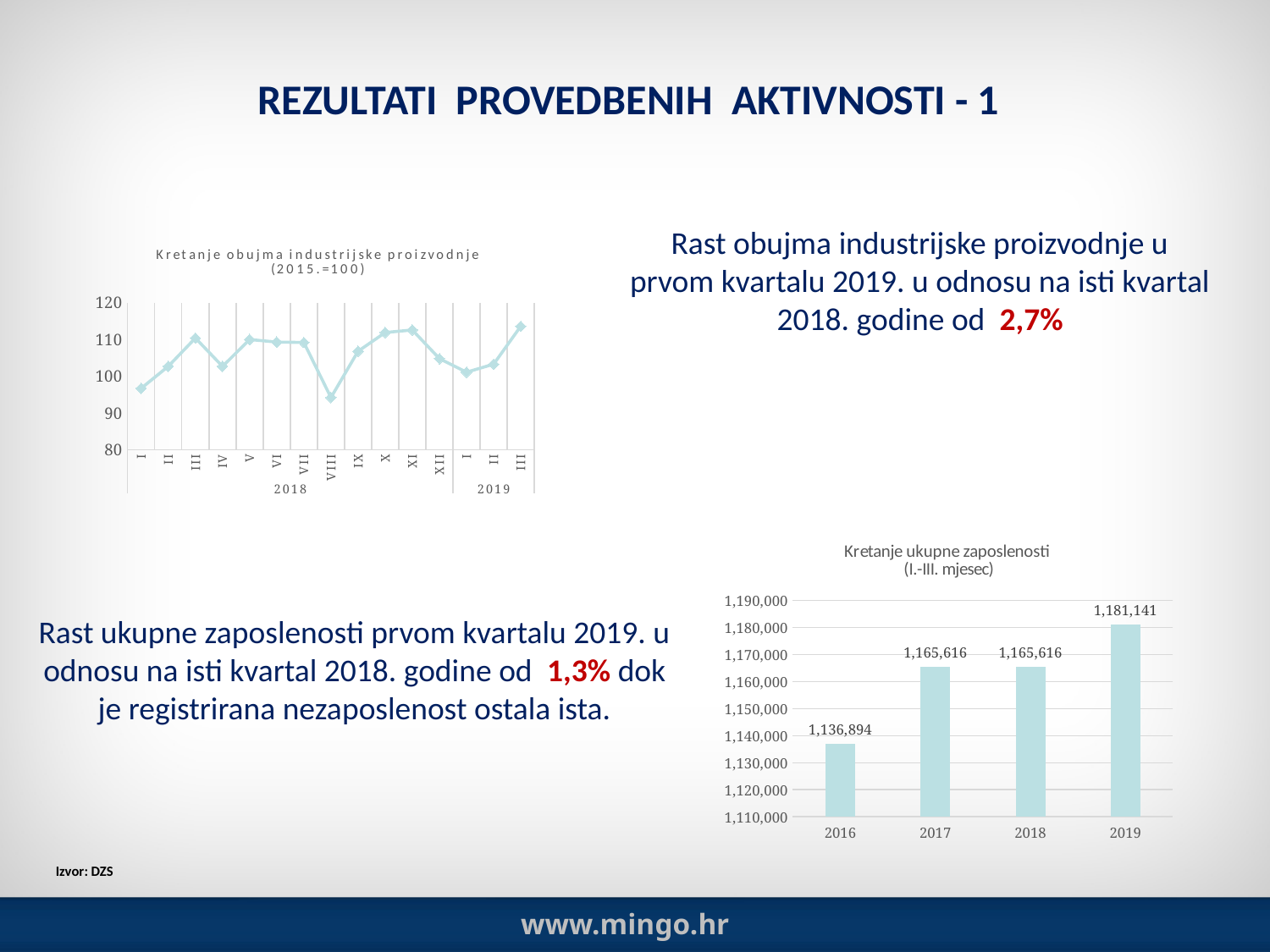
In the chart 'Kretanje obujma industrijske proizvodnje (2015.=100)', is the value for VIII 2018 greater or less than 100? less In the chart 'Kretanje ukupne zaposlenosti (I.-III. mjesec)', what is the value for 2016? 1,136,894 What kind of chart is 'Kretanje obujma industrijske proizvodnje (2015.=100)'? Line chart In the chart 'Kretanje ukupne zaposlenosti (I.-III. mjesec)', what is the difference between the values for 2019 and 2016? 44,247 In the chart 'Kretanje ukupne zaposlenosti (I.-III. mjesec)', is the value for 2017 larger or smaller than the value for 2018? They are equal (1,165,616) In the chart 'Kretanje obujma industrijske proizvodnje (2015.=100)', which month has the lowest value? VIII 2018 How many bars are shown in the chart 'Kretanje ukupne zaposlenosti (I.-III. mjesec)'? 4 In the chart 'Kretanje ukupne zaposlenosti (I.-III. mjesec)', what is the difference between the values for 2019 and 2018? 15,525 In the chart 'Kretanje ukupne zaposlenosti (I.-III. mjesec)', which year has the highest value? 2019 How many data points are plotted in the chart 'Kretanje obujma industrijske proizvodnje (2015.=100)'? 15 In the chart 'Kretanje ukupne zaposlenosti (I.-III. mjesec)', what is the value for 2019? 1,181,141 In the chart 'Kretanje ukupne zaposlenosti (I.-III. mjesec)', which year has the lowest value? 2016